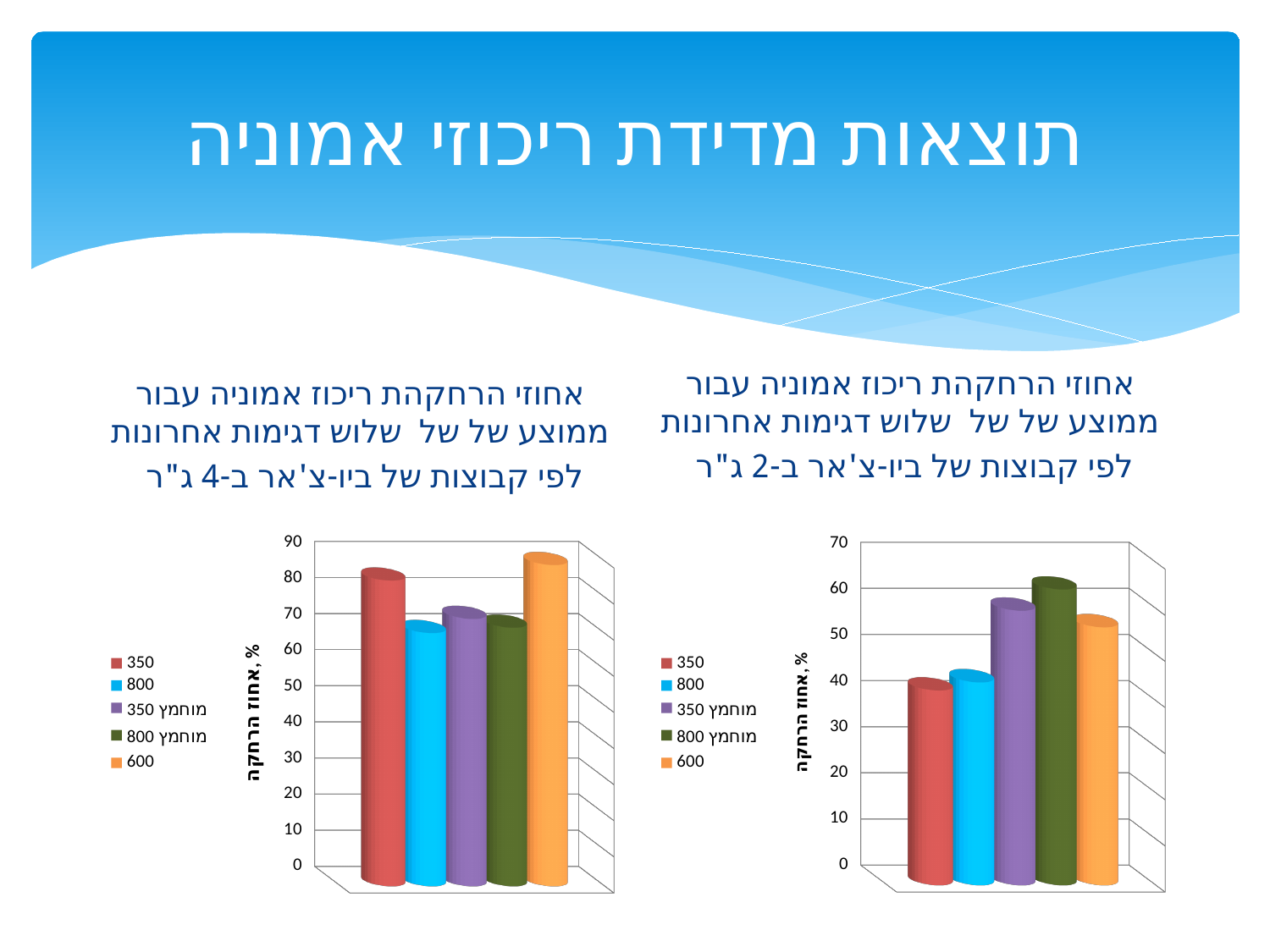
In the left chart (ב-4 ג"ר), which series has the highest value? 600 What is the maximum value shown on the vertical axis of the right chart (ב-2 ג"ר)? 70 How many series does the legend of the right chart (ב-2 ג"ר) list? 5 In the right chart (ב-2 ג"ר), which is larger, the value for מוחמץ 350 or the value for 800? מוחמץ 350 In the left chart (ב-4 ג"ר), which is larger, the value for 350 or the value for 800? 350 In the right chart (ב-2 ג"ר), is the value for מוחמץ 800 greater or less than 50? greater In the left chart (ב-4 ג"ר), is the value for 600 greater or less than 80? greater What kind of chart is the left chart (ב-4 ג"ר)? bar chart In the right chart (ב-2 ג"ר), which series has the highest value? מוחמץ 800 What is the vertical axis title of the left chart (ב-4 ג"ר)? אחוז הרחקה, %